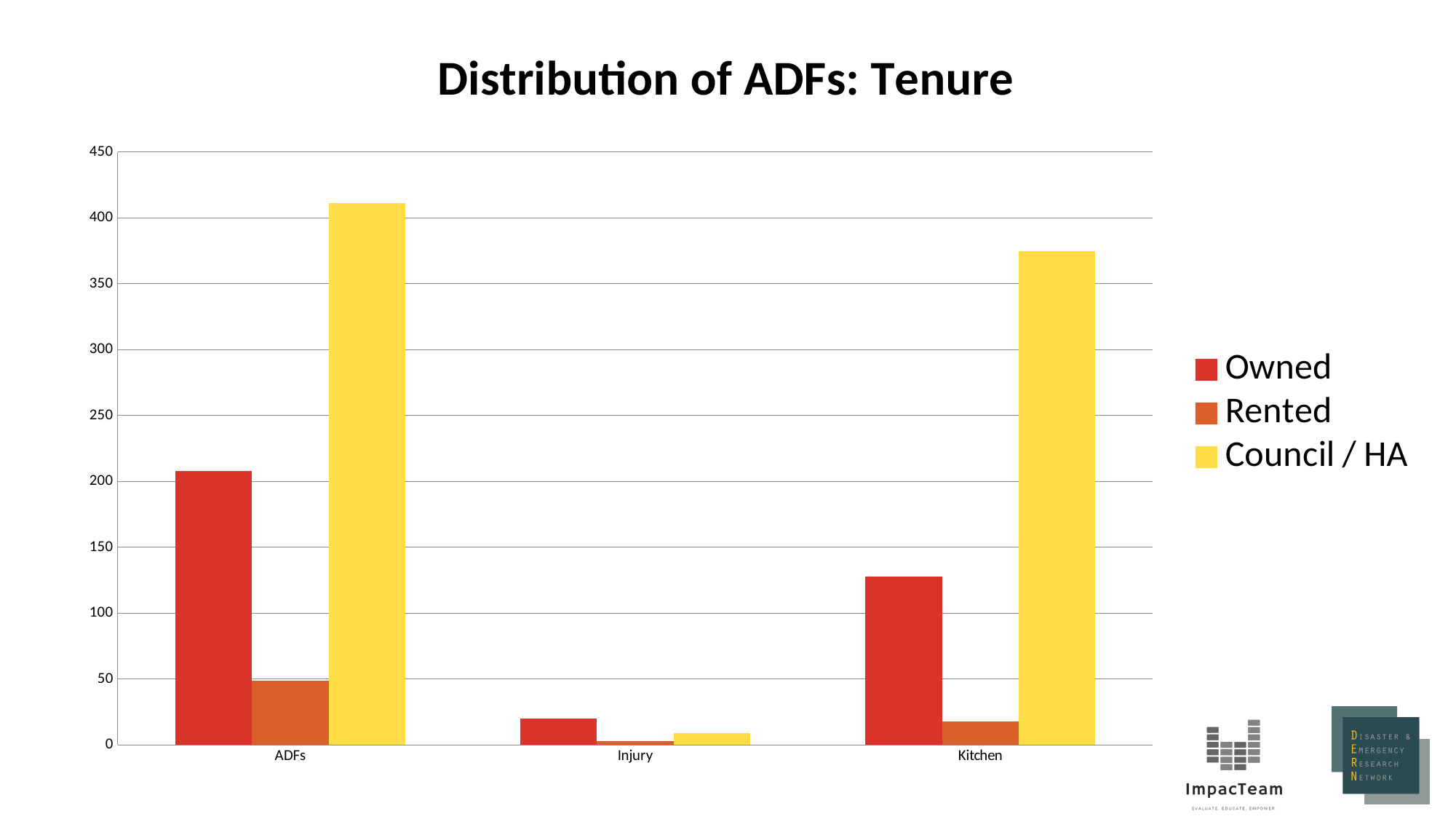
For Injury, which is larger: Owned or Council / HA? Owned How many categories are shown on the x axis? 3 Which category has the lowest Owned value? Injury Is the Owned value for Kitchen greater or less than 100? greater How many series does the legend list? 3 For Kitchen, which is larger: Owned or Council / HA? Council / HA Which category has the highest Owned value? ADFs What kind of chart is shown on the slide? bar chart Which category has the highest Council / HA value? ADFs Is the Rented value for ADFs greater or less than 100? less Is the Council / HA value for ADFs greater or less than 350? greater What is the title of the chart? Distribution of ADFs: Tenure